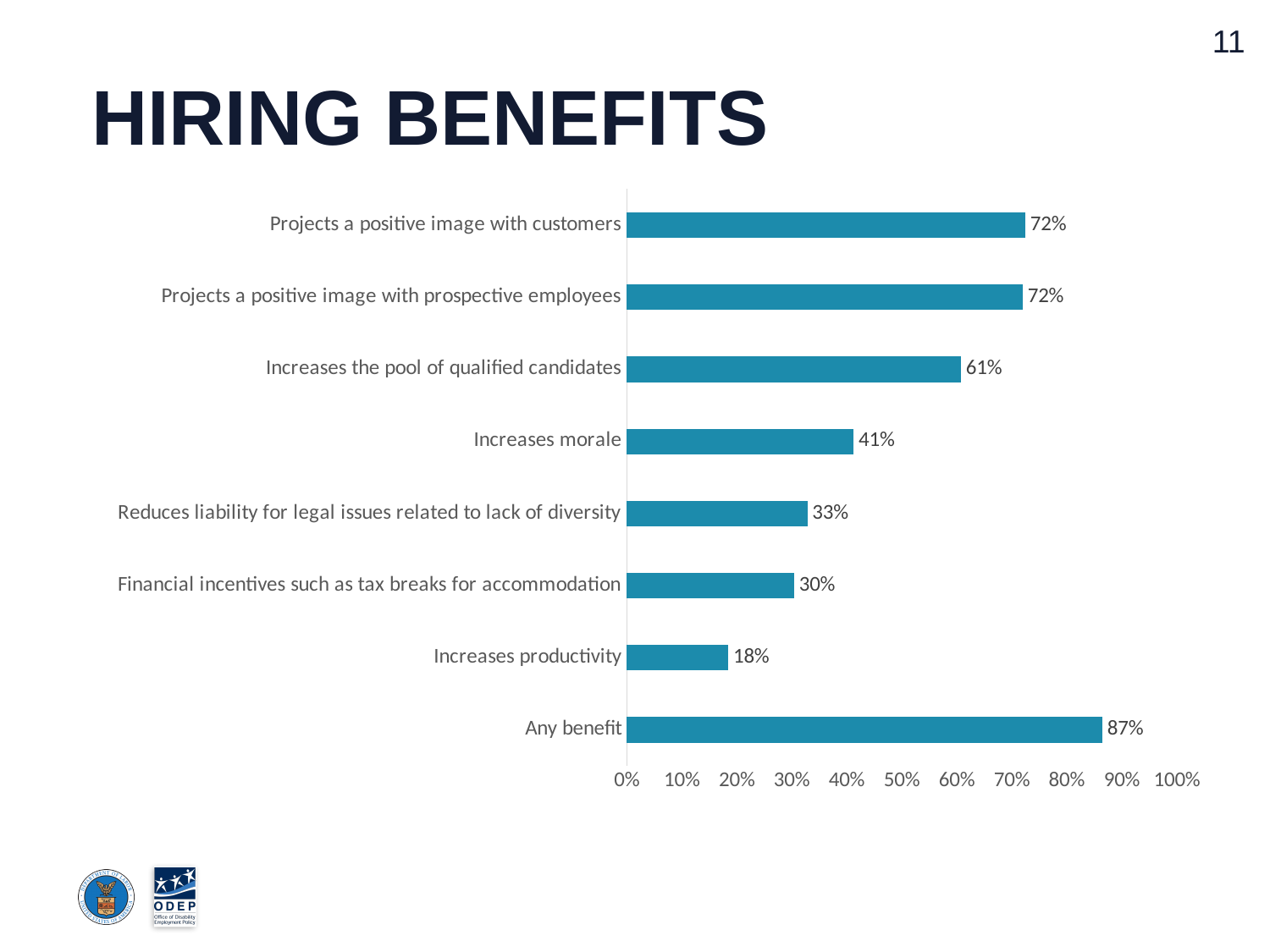
What is the difference between the values for "Increases morale" and "Increases productivity"? 23% What is the value for "Any benefit"? 87% What is the value for "Increases productivity"? 18% Which is larger: the value for "Reduces liability for legal issues related to lack of diversity" or the value for "Financial incentives such as tax breaks for accommodation"? Reduces liability for legal issues related to lack of diversity What is the value for "Financial incentives such as tax breaks for accommodation"? 30% What kind of chart is shown on the slide? Bar chart Which category has the lowest value? Increases productivity Which category has the highest value? Any benefit What is the title of the slide? HIRING BENEFITS What is the difference between the values for "Any benefit" and "Increases the pool of qualified candidates"? 26% How many categories are shown in the chart? 8 What is the value for "Increases the pool of qualified candidates"? 61%